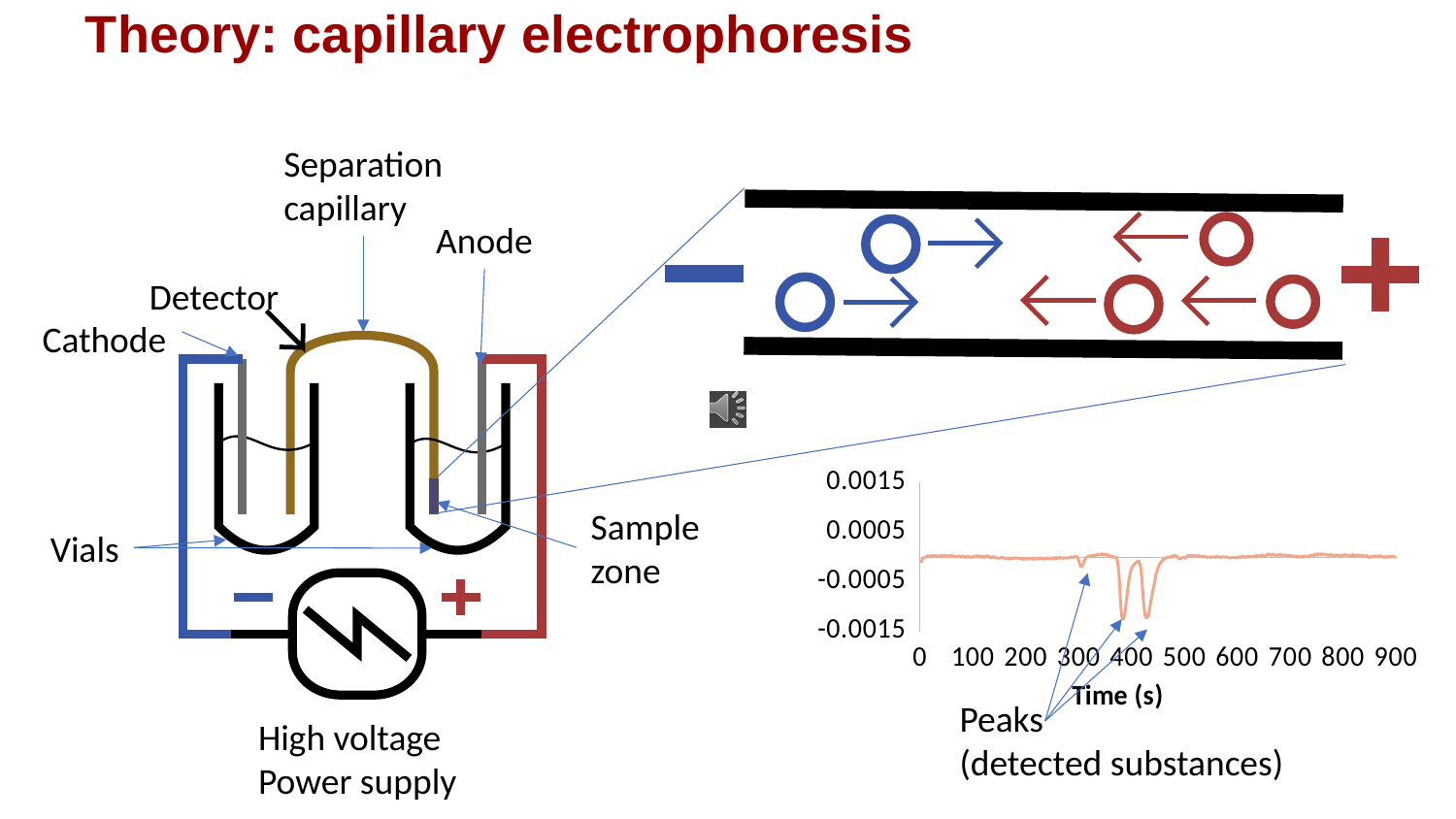
What is the highest tick value shown on the y axis of the chart at the bottom right? 0.0015 What is the lowest tick value shown on the y axis of the chart at the bottom right? -0.0015 How many lines (series) are plotted on the chart at the bottom right? 1 What is the highest value shown on the x axis of the chart at the bottom right? 900 How many peaks (detected substances) are pointed out by arrows on the chart at the bottom right? 3 On the chart at the bottom right, between which two x-axis tick values do the peaks occur? 300 and 500 On the chart at the bottom right, is the value at the deepest peak near 400 s greater or less than -0.0005? less What is the label of the x axis of the chart at the bottom right? Time (s) On the chart at the bottom right, do the peaks point upward or downward from the baseline? downward What kind of chart is shown at the bottom right of the slide? line chart On the chart at the bottom right, is the value of the line at 800 s greater or less than 0.0005? less On the chart at the bottom right, is the value of the line at 100 s greater or less than -0.0005? greater